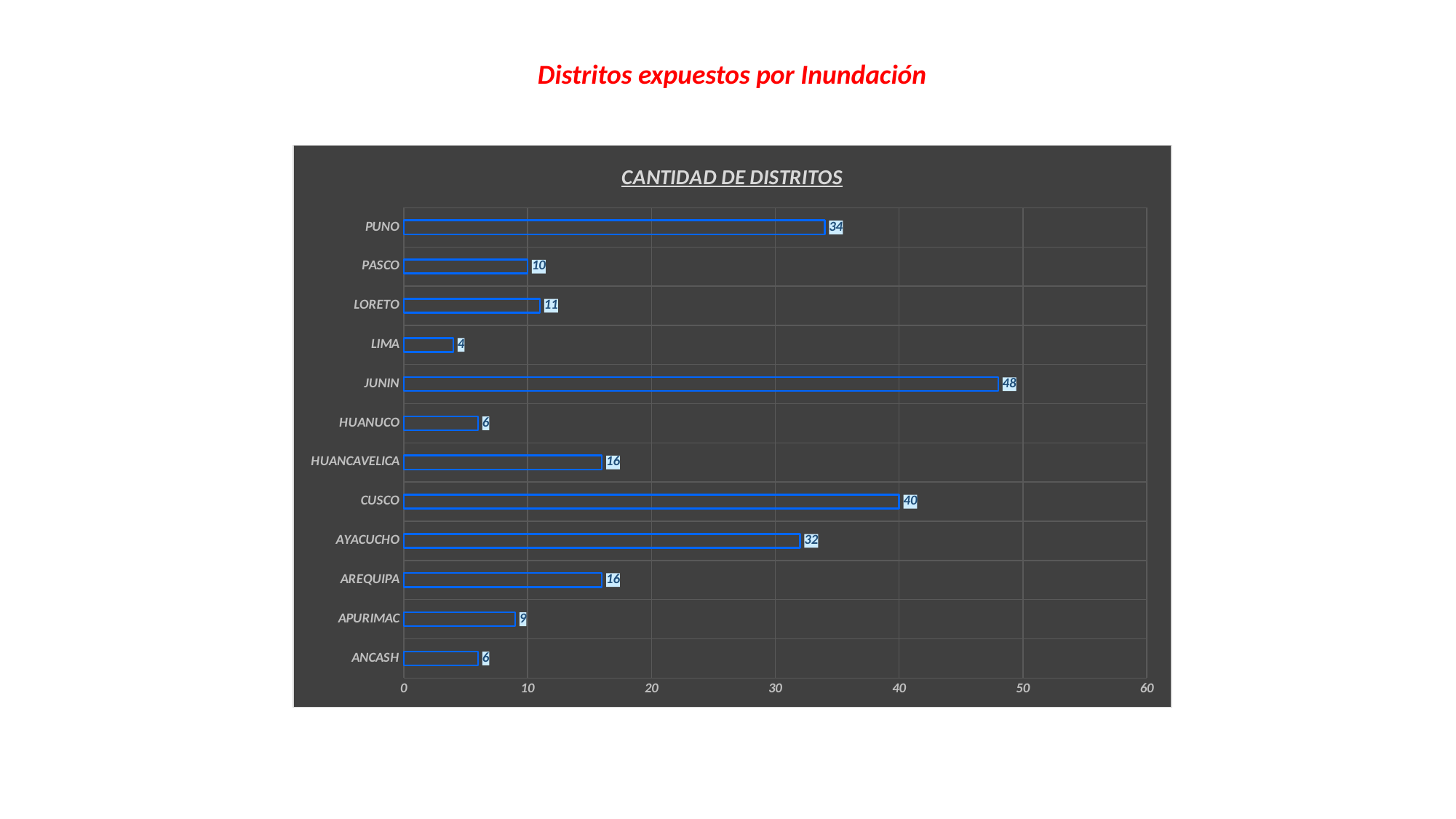
What is the value for JUNIN? 48 What is the title of the chart? CANTIDAD DE DISTRITOS How many categories are shown in the chart? 12 Is the value for PUNO greater or less than 30? greater Which is larger, the value for AYACUCHO or the value for CUSCO? CUSCO What kind of chart is shown? bar chart What is the value for LIMA? 4 What is the value for CUSCO? 40 What is the difference between the values for HUANCAVELICA and HUANUCO? 10 Which category has the lowest value? LIMA Which category has the highest value? JUNIN What is the difference between the values for JUNIN and PUNO? 14